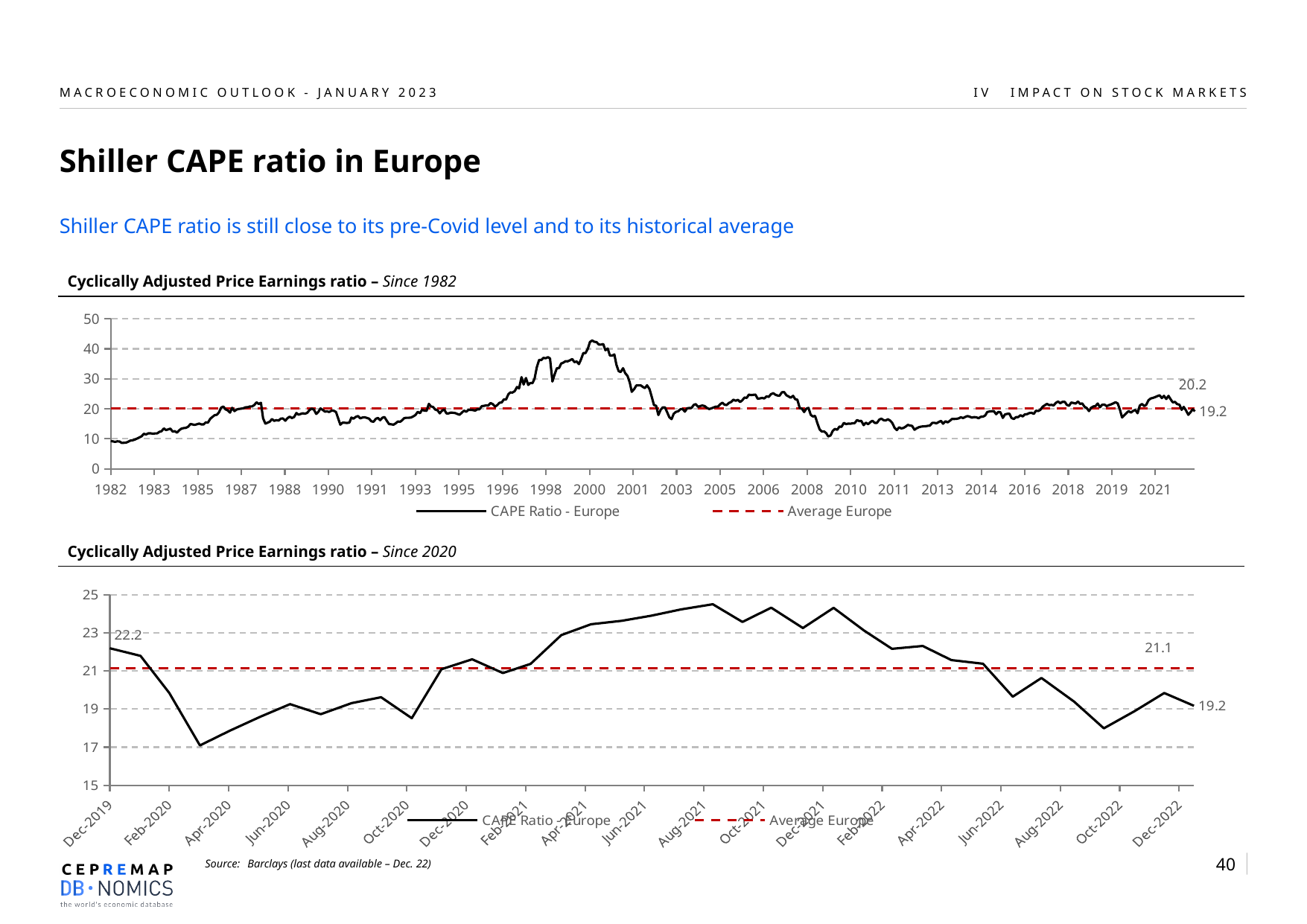
In the 'Since 2020' chart, what is the value of the CAPE Ratio - Europe at Dec-2022? 19.2 In the 'Since 2020' chart, what is the value of the CAPE Ratio - Europe at Dec-2019? 22.2 In the 'Since 2020' chart, does the CAPE Ratio - Europe rise or fall between Aug-2021 and Dec-2022? Fall What type of chart is the 'Since 2020' chart? Line chart In the 'Since 1982' chart, is the latest CAPE Ratio - Europe value (19.2) greater or less than the Average Europe value (20.2)? less In the 'Since 1982' chart, what is the latest value of the CAPE Ratio - Europe series? 19.2 In the 'Since 1982' chart, what value is labelled for the Average Europe line? 20.2 In the 'Since 2020' chart, is the CAPE Ratio - Europe value at Apr-2020 greater or less than 19? less In the 'Since 2020' chart, what value is labelled for the Average Europe line? 21.1 In the 'Since 1982' chart, is the peak of the CAPE Ratio - Europe around 2000 greater or less than 40? greater In the 'Since 2020' chart, what is the difference between the Dec-2019 value (22.2) and the Dec-2022 value (19.2) of the CAPE Ratio - Europe? 3.0 How many series does the legend of the 'Since 1982' chart list? 2